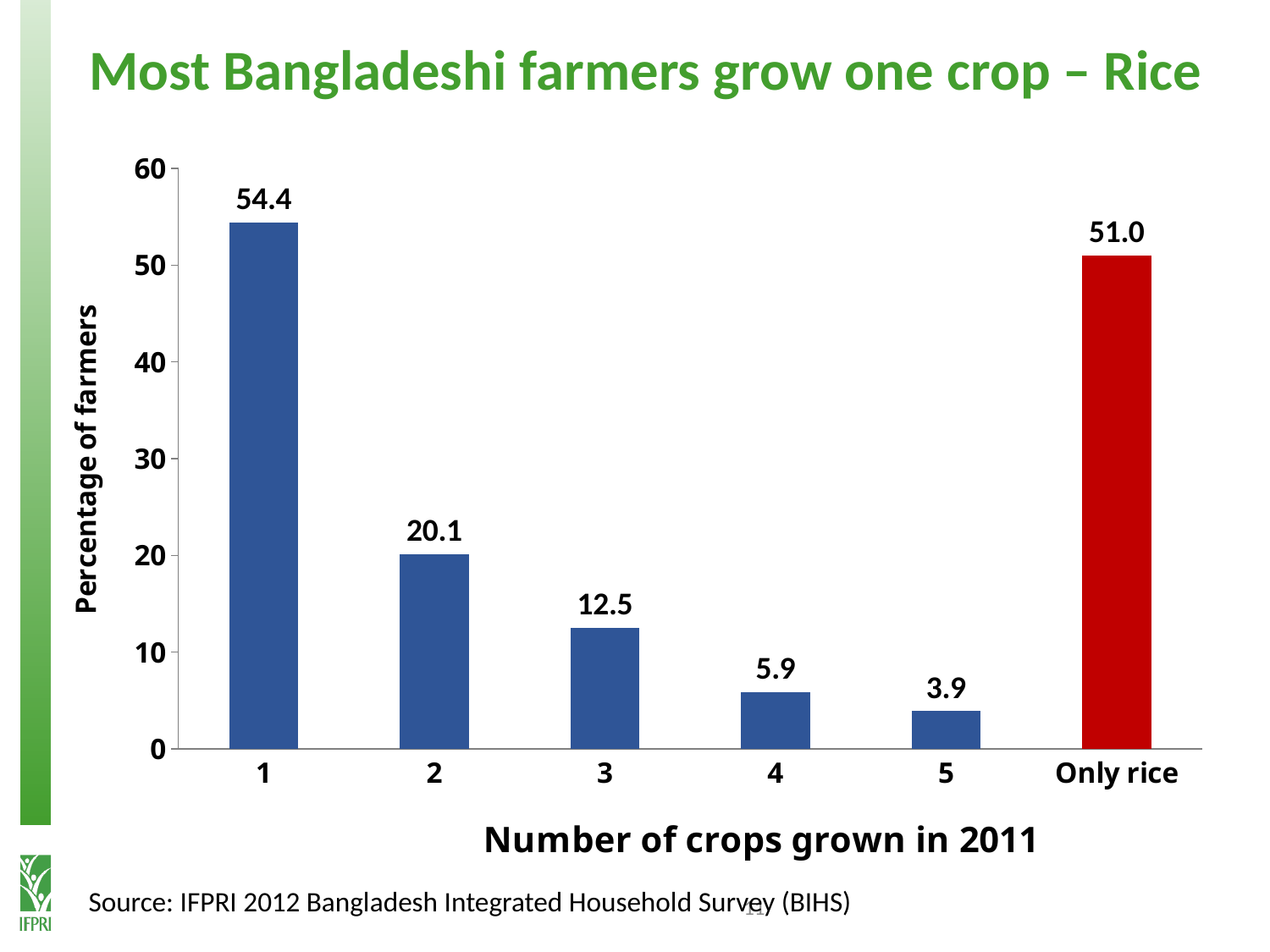
What percentage of farmers grew 1 crop in 2011? 54.4 What is the label of the y axis? Percentage of farmers Which category has the lowest percentage of farmers? 5 Is the value for 2 crops greater or less than 30? less Which is larger: the value for 4 crops or the value for 5 crops? 4 crops What is the value for farmers growing 3 crops? 12.5 Which category has the highest percentage of farmers? 1 How many bars are shown in the chart? 6 What is the difference between the percentage of farmers growing 1 crop and those growing 2 crops? 34.3 What type of chart is shown on the slide? bar chart What is the difference between the value for 1 crop and the value for Only rice? 3.4 What percentage of farmers grew only rice? 51.0